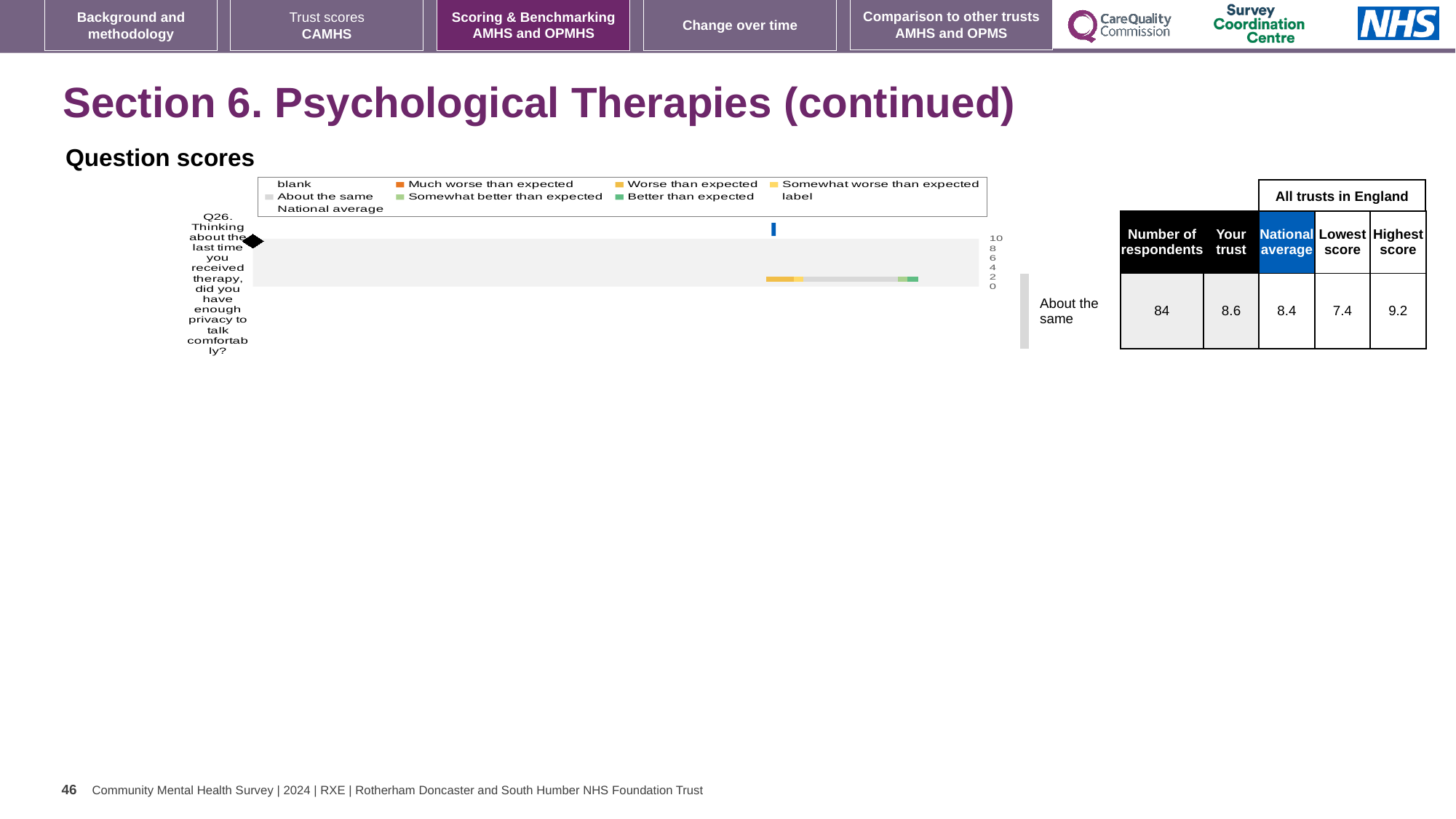
According to the table beside the chart, which is larger for Q26: the 'Your trust' score or the national average? Your trust What is the highest value shown on the axis of the Question scores chart? 10 Which question is plotted in the Question scores chart? Q26. Thinking about the last time you received therapy, did you have enough privacy to talk comfortably? What benchmark category label is shown next to the Q26 bar? About the same According to the table beside the chart, how many respondents answered Q26? 84 Which legend entry in the Question scores chart is shown in orange? Much worse than expected According to the table beside the chart, what is the national average score for Q26? 8.4 How many entries does the legend of the Question scores chart list? 9 What kind of chart is shown under 'Question scores'? bar chart How many questions (categories) are plotted in the Question scores chart? 1 According to the table beside the chart, what is the difference between the highest score (9.2) and the lowest score (7.4) for Q26? 1.8 According to the table beside the chart, what is the 'Your trust' score for Q26? 8.6